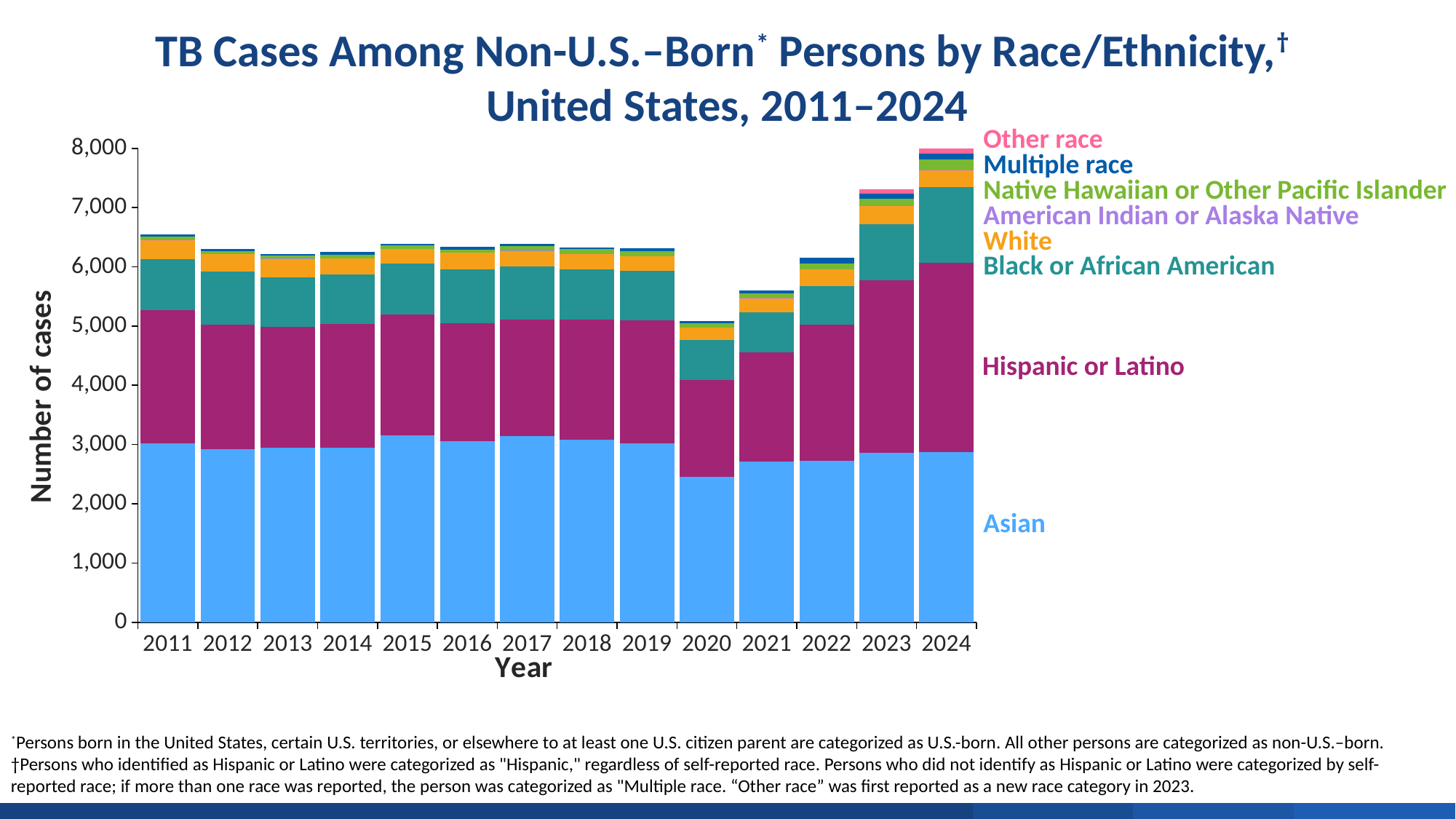
Is the total number of cases in 2020 greater or less than 6,000? less Which race/ethnicity category forms the bottom segment of each stacked bar? Asian Do the total number of cases rise or fall from 2020 to 2024? rise What is the title of the chart? TB Cases Among Non-U.S.–Born Persons by Race/Ethnicity, United States, 2011–2024 Which year has the highest total number of TB cases among non-U.S.-born persons? 2024 How many race/ethnicity categories does the legend list? 8 Is the number of Asian cases in 2020 greater or less than 3,000? less Which year has a larger total number of cases, 2023 or 2022? 2023 Is the total number of cases in 2024 greater or less than 7,000? greater What kind of chart is shown on the slide? Stacked bar chart Which year has the lowest total number of TB cases among non-U.S.-born persons? 2020 How many years (bars) are shown on the x axis? 14